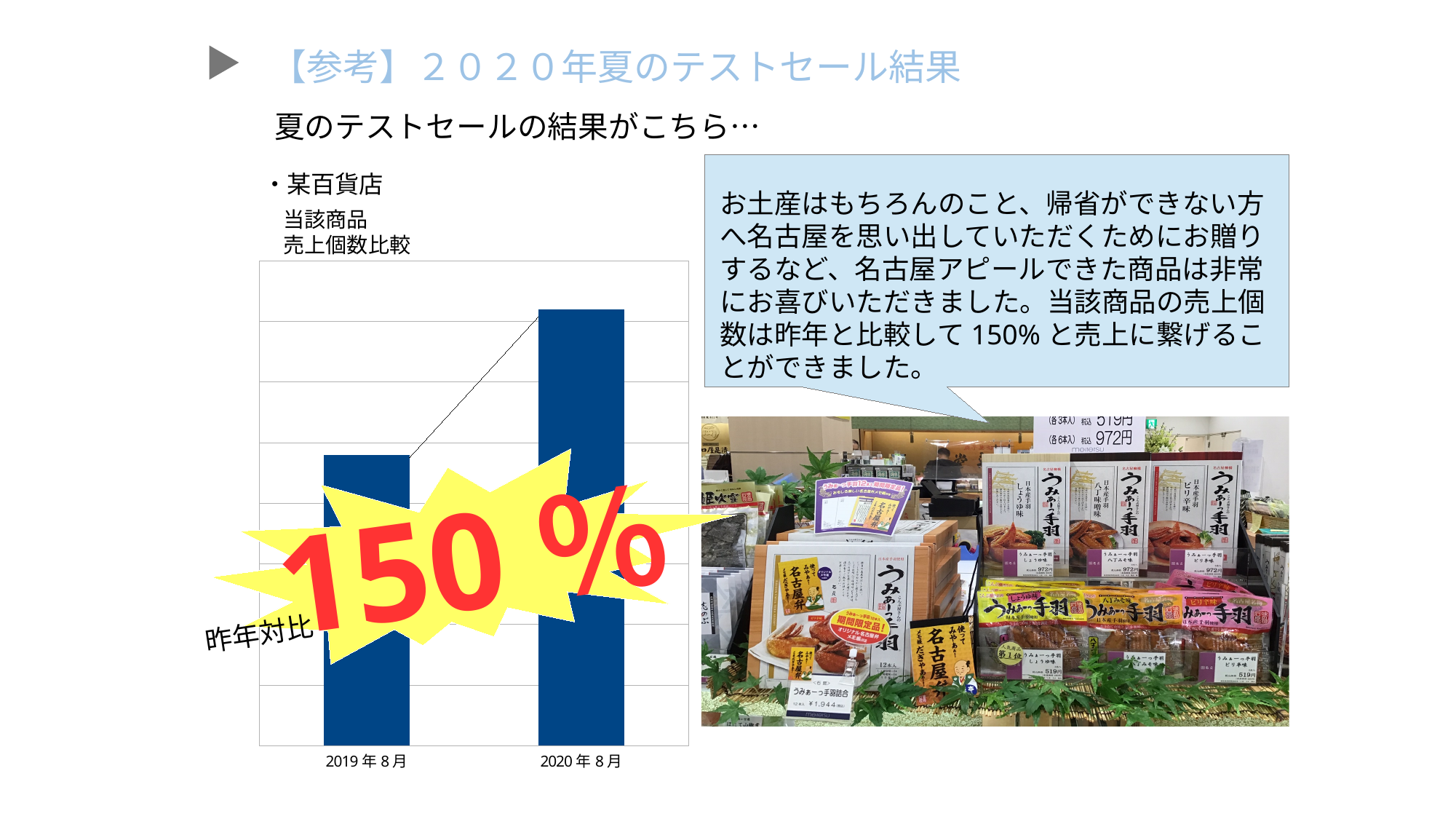
What kind of chart is shown on the slide? bar chart Which category has the higher bar in the chart? 2020年8月 What is the title written above the chart? 当該商品 売上個数比較 What are the two category labels on the x axis of the chart? 2019年8月, 2020年8月 Is the bar for 2020年8月 taller or shorter than the bar for 2019年8月? taller How many bars are plotted in the chart? 2 Which category has the lower bar in the chart? 2019年8月 What year-on-year ratio (昨年対比) is printed over the chart? 150% Do the values rise or fall from 2019年8月 to 2020年8月? rise